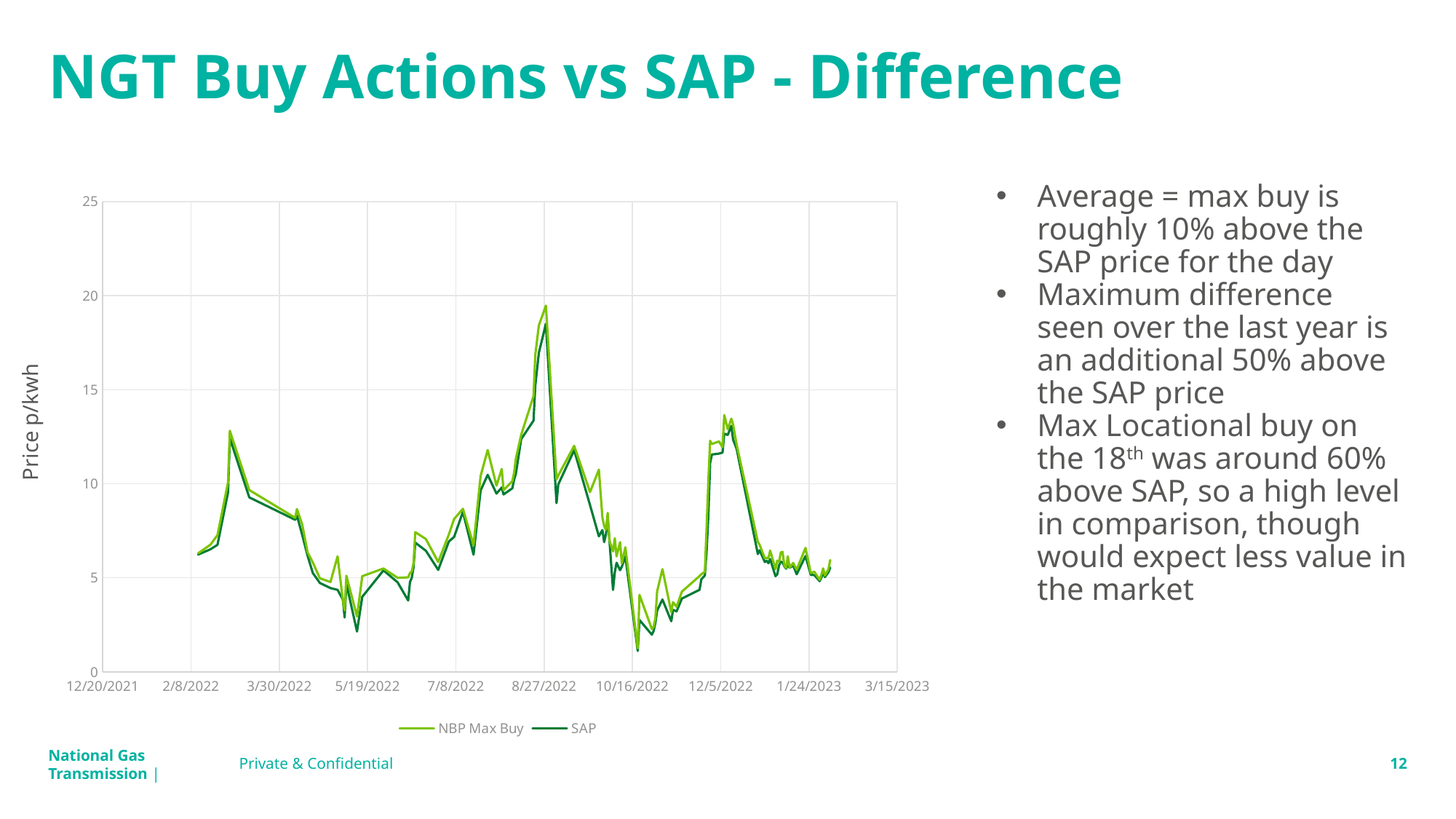
Near which x-axis date do both series reach their highest peak? 8/27/2022 At the highest peak near 8/27/2022, which series reaches the higher value, NBP Max Buy or SAP? NBP Max Buy Is the peak value of NBP Max Buy near 8/27/2022 greater or less than 20? less How many series does the chart legend list? 2 What kind of chart is shown on the slide? line chart Is the value of NBP Max Buy at the first plotted point near 2/8/2022 greater or less than 5? greater Near which x-axis date do both series reach their lowest point? 10/16/2022 Is the lowest value of SAP near 10/16/2022 greater or less than 5? less Do the values rise or fall between the peak near 8/27/2022 and 10/16/2022? fall What is the label on the vertical axis of the chart? Price p/kwh What are the two series named in the chart legend? NBP Max Buy and SAP